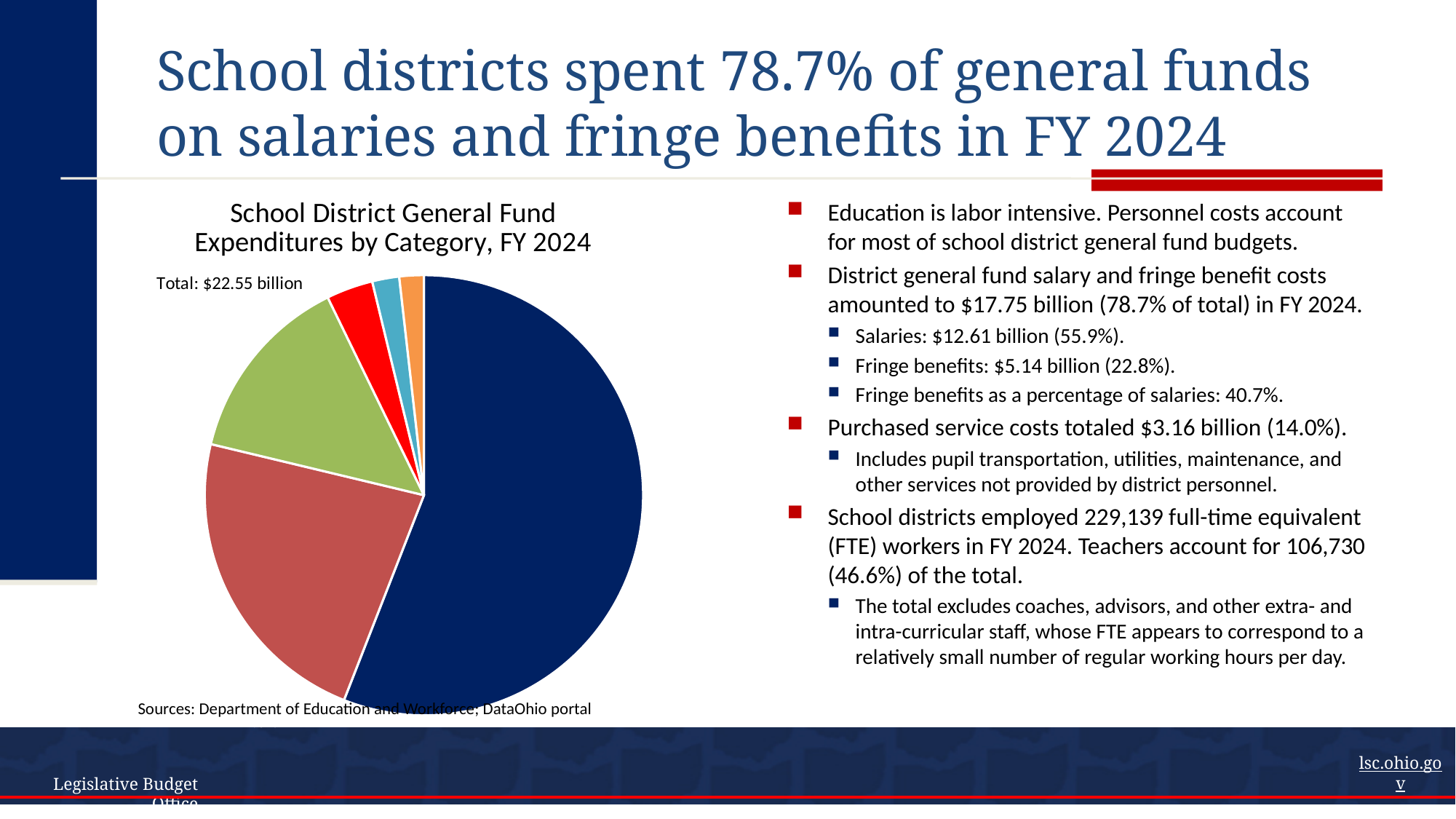
Is the dark blue slice's share of the pie greater or less than 25%? greater What sources are cited below the chart? Department of Education and Workforce; DataOhio portal What kind of chart is shown on the slide? pie chart How many slices does the pie chart have? 6 Which colour slice is the largest in the pie chart? dark blue What is the title of the chart on the slide? School District General Fund Expenditures by Category, FY 2024 Is the red-brown slice's share of the pie greater or less than 50%? less Which is larger in the pie chart, the dark blue slice or the red-brown slice? dark blue What total amount is printed next to the pie chart? $22.55 billion Which is larger in the pie chart, the green slice or the bright red slice? green